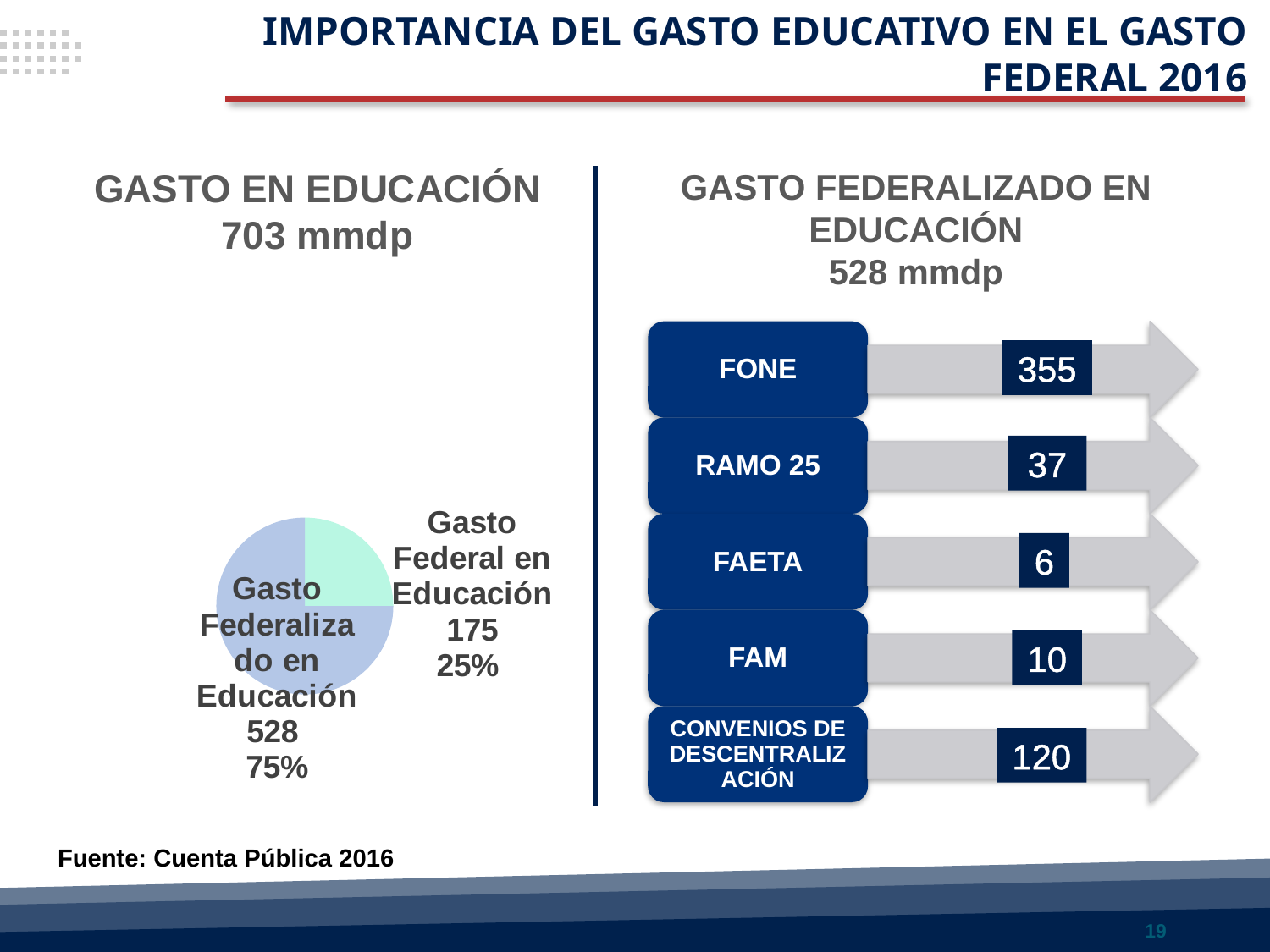
In the pie chart on the left, what share of the pie does Gasto Federalizado en Educación represent? 75% In the pie chart on the left, what is the difference between the values for Gasto Federalizado en Educación and Gasto Federal en Educación? 353 In the pie chart on the left, which slice is larger: Gasto Federalizado en Educación or Gasto Federal en Educación? Gasto Federalizado en Educación In the pie chart on the left, what share of the pie does Gasto Federal en Educación represent? 25% What kind of chart is shown under the heading "GASTO EN EDUCACIÓN 703 mmdp"? pie chart How many slices does the pie chart on the left have? 2 In the "GASTO FEDERALIZADO EN EDUCACIÓN" diagram on the right, which item has the lowest value? FAETA In the pie chart on the left, what is the value for Gasto Federalizado en Educación? 528 In the "GASTO FEDERALIZADO EN EDUCACIÓN" diagram on the right, how many items are listed? 5 In the "GASTO FEDERALIZADO EN EDUCACIÓN" diagram on the right, what is the value for FONE? 355 What total amount is stated in the heading above the pie chart on the left? 703 mmdp In the pie chart on the left, what is the value for Gasto Federal en Educación? 175